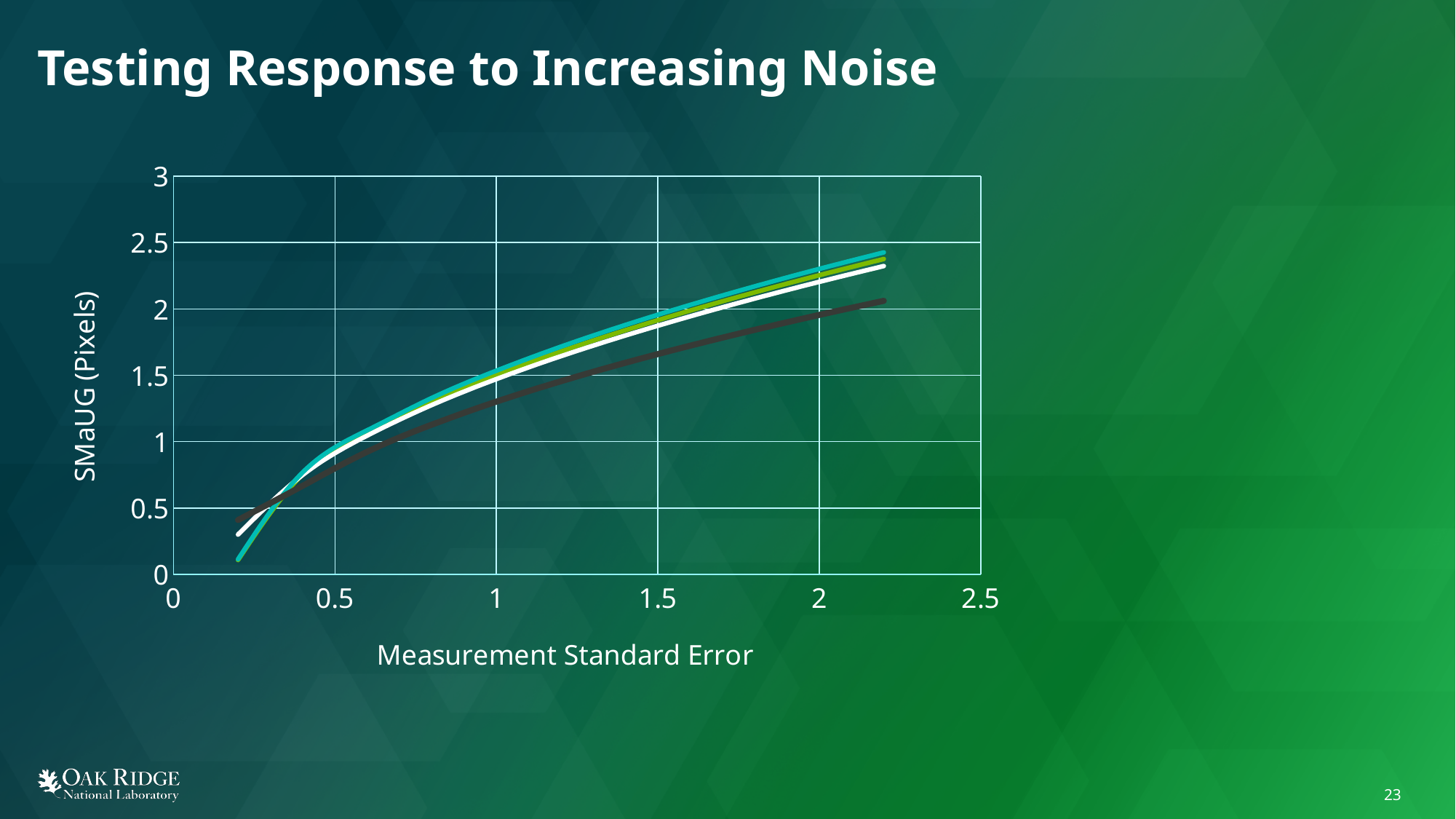
What is the label of the x axis? Measurement Standard Error Do the plotted values rise or fall as Measurement Standard Error increases? rise What kind of chart is shown on the slide? line chart How many lines are plotted on the chart? 4 Is the value of the dark gray line at a Measurement Standard Error of 1 greater or less than 1? greater Is the value of the white line at its right end (Measurement Standard Error of about 2.2) greater or less than 2.5? less Is the value of the teal line at a Measurement Standard Error of 2 greater or less than 2? greater Which line is lowest at the right end of the chart (Measurement Standard Error of about 2.2)? the dark gray line At a Measurement Standard Error of 2.2, is the teal line or the dark gray line higher? the teal line What is the label of the y axis? SMaUG (Pixels)